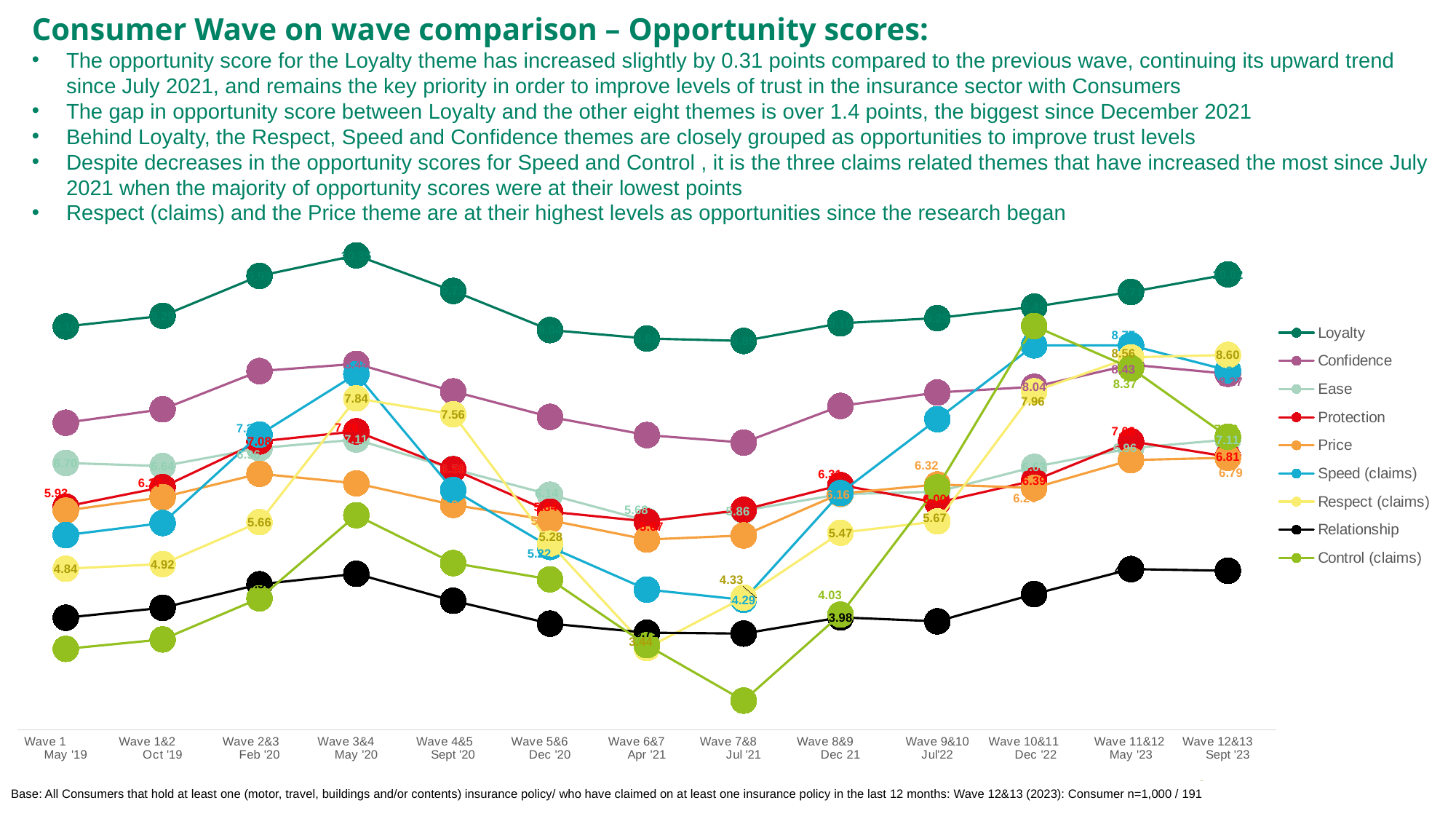
Which theme has the highest opportunity score at Wave 12&13 Sept '23? Loyalty What is the Relationship score at Wave 8&9 Dec 21? 3.98 What is the Respect (claims) score at Wave 12&13 Sept '23? 8.60 Which theme has the lowest opportunity score at Wave 7&8 Jul '21? Control (claims) What is the difference between the Respect (claims) scores at Wave 3&4 May '20 and Wave 2&3 Feb '20? 2.18 How many waves are shown along the x axis? 13 Does the Loyalty line rise or fall from Wave 7&8 Jul '21 to Wave 12&13 Sept '23? rise Which is larger for Respect (claims): the score at Wave 3&4 May '20 or at Wave 4&5 Sept '20? Wave 3&4 May '20 How many series does the legend list? 9 What is the Speed (claims) score at Wave 7&8 Jul '21? 4.29 What kind of chart is shown on the slide? line chart What is the Respect (claims) score at Wave 1 May '19? 4.84